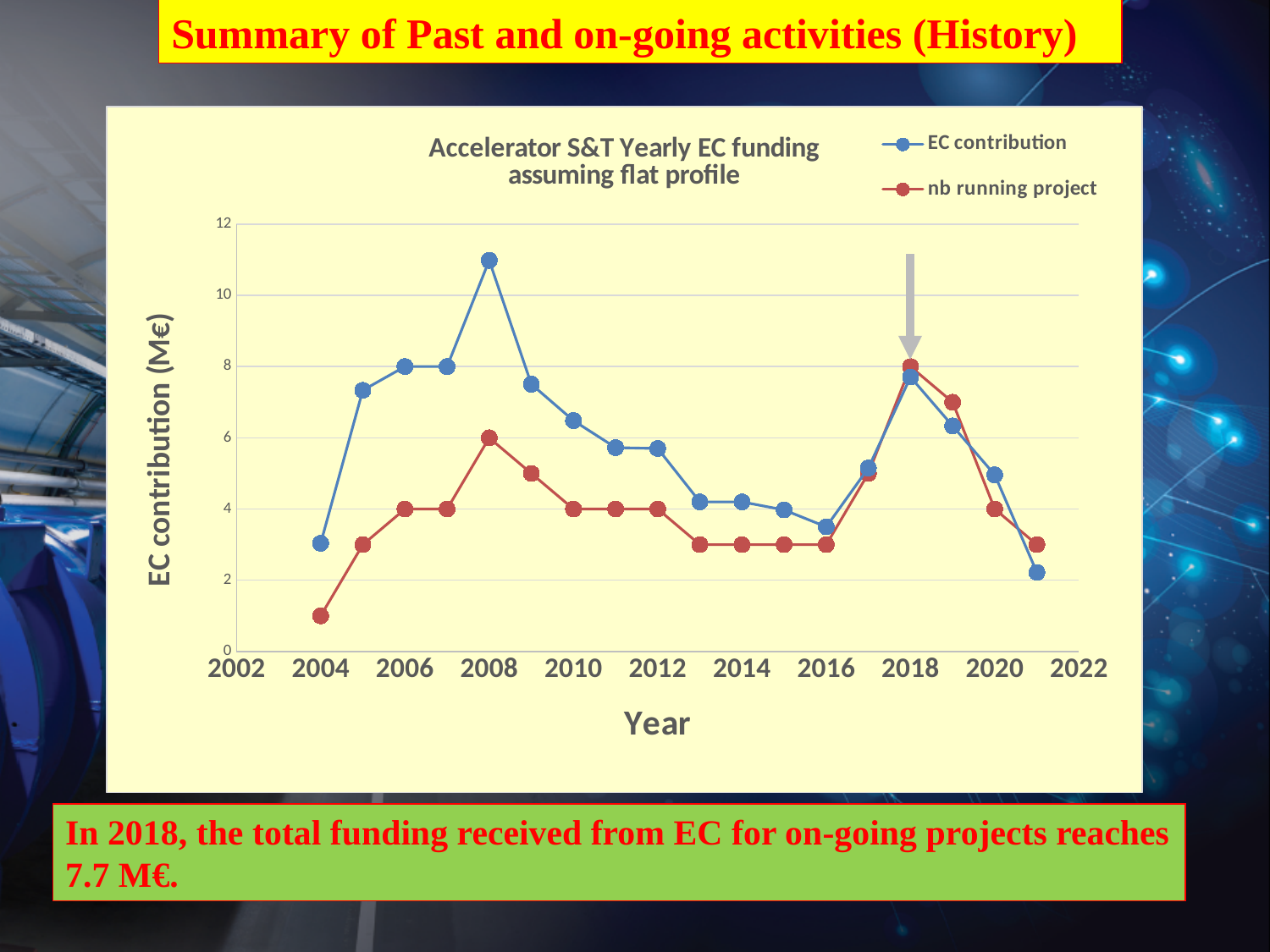
What are the two series named in the legend? EC contribution and nb running project In 2010, which series has the larger value, EC contribution or nb running project? EC contribution Is the EC contribution value for 2008 greater or less than 10? greater In which year does the EC contribution series reach its highest value? 2008 In which year is the nb running project series at its lowest? 2004 What is the label of the vertical axis? EC contribution (M€) Is the EC contribution value for 2021 greater or less than 4? less In which year is the EC contribution series at its lowest? 2021 Does the EC contribution series rise or fall from 2018 to 2021? fall How many series does the chart legend list? 2 In which year does the nb running project series reach its highest value? 2018 What kind of chart is shown on the slide? line chart